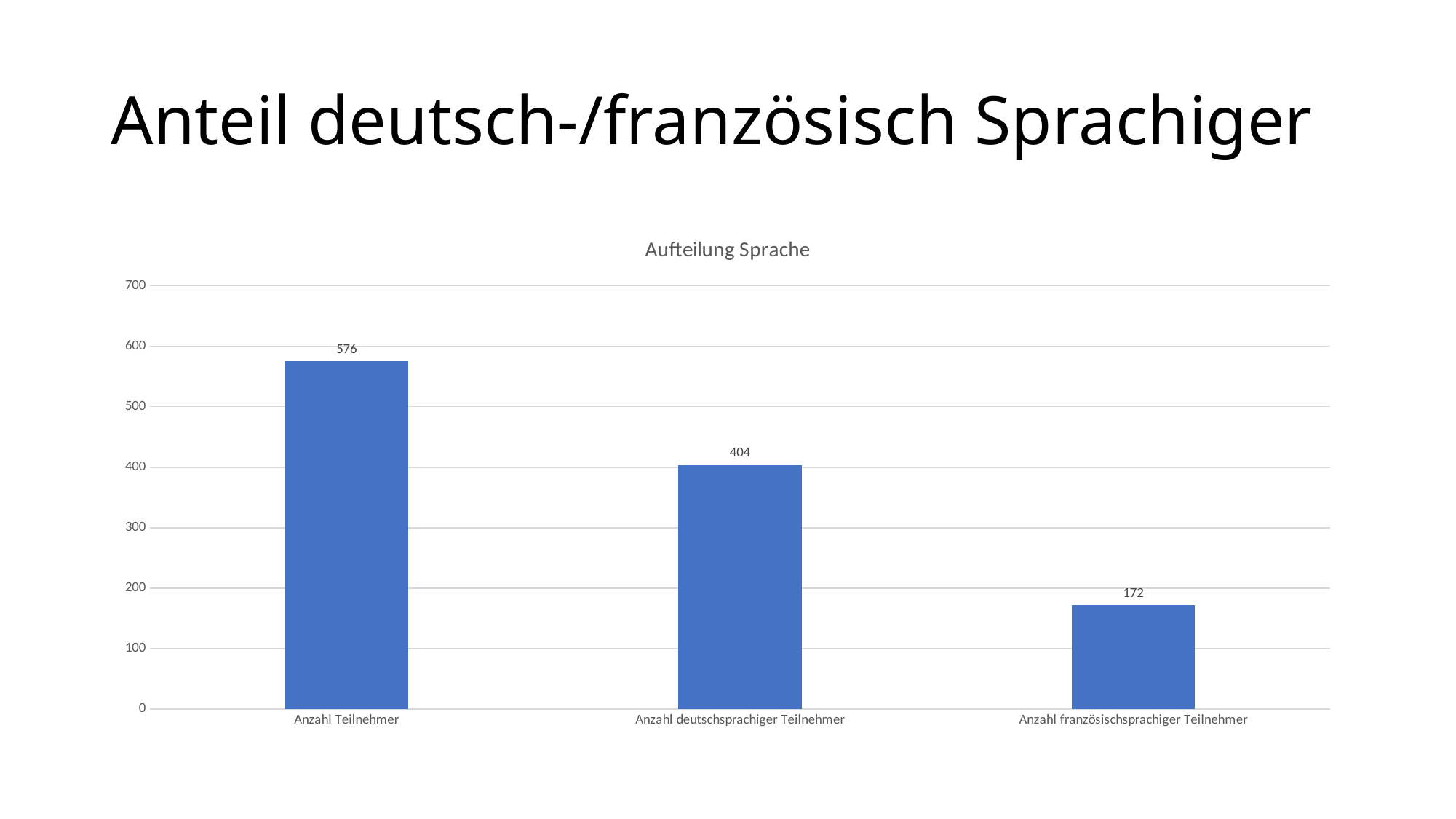
Is the value for Anzahl französischsprachiger Teilnehmer greater or less than 200? less Which is larger, Anzahl deutschsprachiger Teilnehmer or Anzahl französischsprachiger Teilnehmer? Anzahl deutschsprachiger Teilnehmer What is the value for Anzahl Teilnehmer? 576 Which category has the lowest value? Anzahl französischsprachiger Teilnehmer Which category has the highest value? Anzahl Teilnehmer What is the value for Anzahl französischsprachiger Teilnehmer? 172 What is the difference between Anzahl deutschsprachiger Teilnehmer and Anzahl französischsprachiger Teilnehmer? 232 What is the title of the chart? Aufteilung Sprache How many categories are shown in the chart? 3 What is the difference between Anzahl Teilnehmer and Anzahl deutschsprachiger Teilnehmer? 172 What is the value for Anzahl deutschsprachiger Teilnehmer? 404 What kind of chart is shown on the slide? bar chart